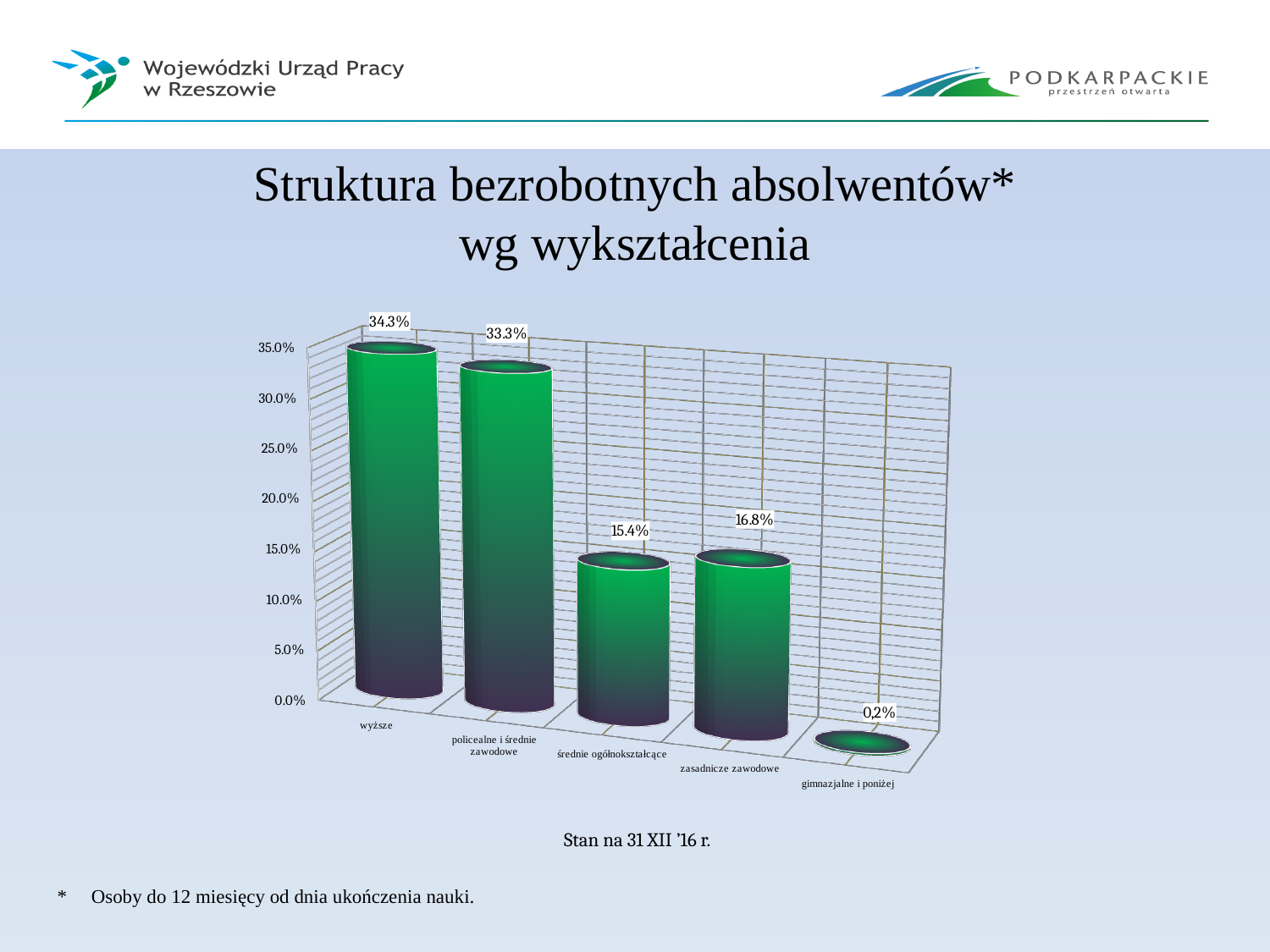
Which education category has the lowest share? gimnazjalne i poniżej What is the value for zasadnicze zawodowe? 16.8% What is the value for policealne i średnie zawodowe? 33.3% What date is given below the chart as the reference date (Stan na)? 31 XII '16 r. How many education categories are shown in the chart? 5 What is the value for średnie ogólnokształcące? 15.4% What is the value for wyższe? 34.3% What is the difference between the values for wyższe and policealne i średnie zawodowe? 1.0% Which education category has the highest share? wyższe What kind of chart is shown on the slide? bar chart Which is larger, the value for zasadnicze zawodowe or the value for średnie ogólnokształcące? zasadnicze zawodowe What is the value for gimnazjalne i poniżej? 0,2%